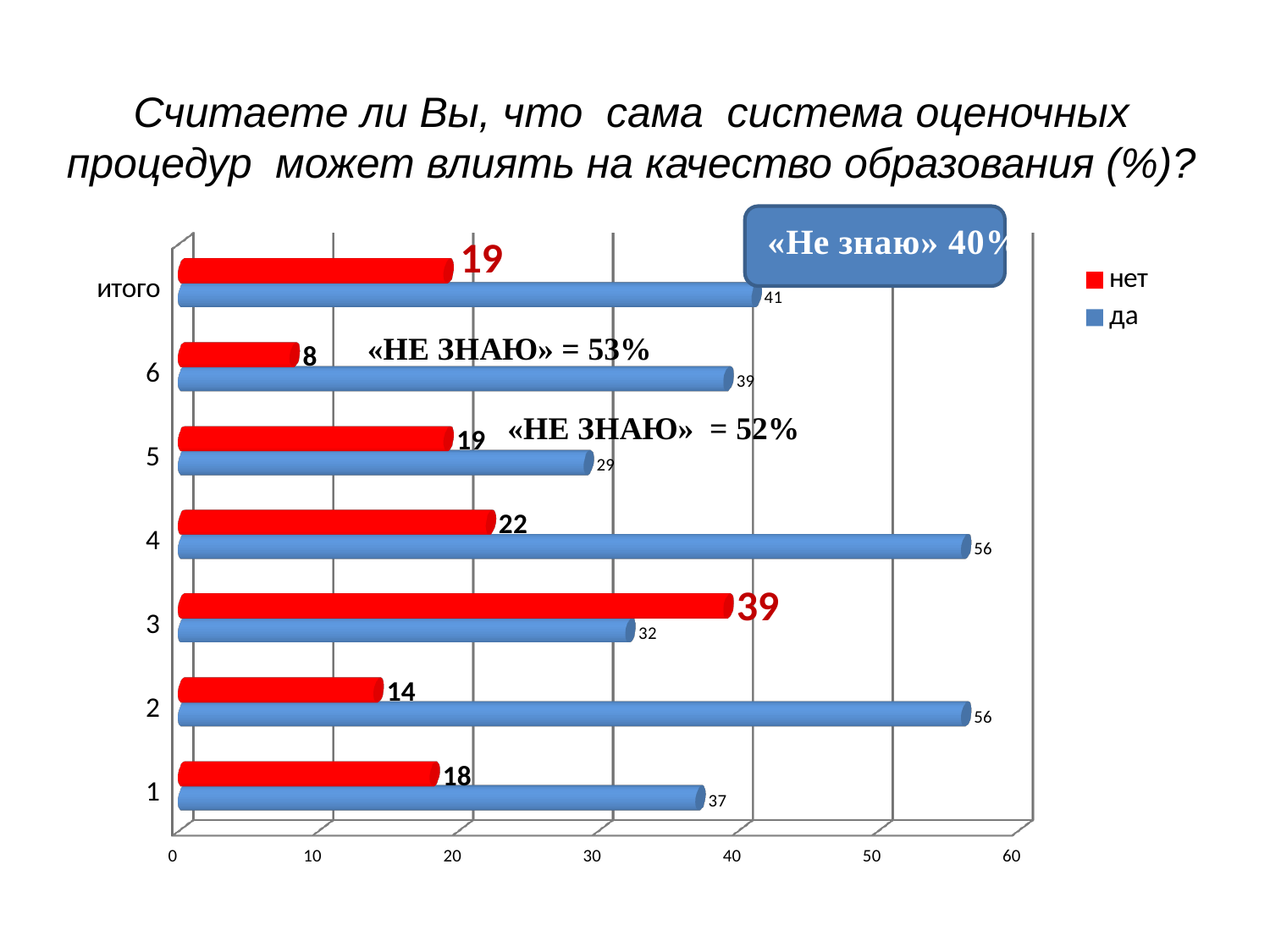
What is the value of the "да" series for "итого"? 41 How many series does the legend list? 2 Which category has the lowest value in the "да" series? 5 What is the value of the "нет" series for category 3? 39 What is the difference between the "да" and "нет" values for category 1? 19 What is the value of the "нет" series for category 6? 8 What is the value of the "да" series for category 4? 56 Which category has the highest value in the "нет" series? 3 How many categories are shown on the vertical axis? 7 Which category has the lowest value in the "нет" series? 6 For category 3, which is larger: the "да" value or the "нет" value? нет What kind of chart is shown on the slide? bar chart